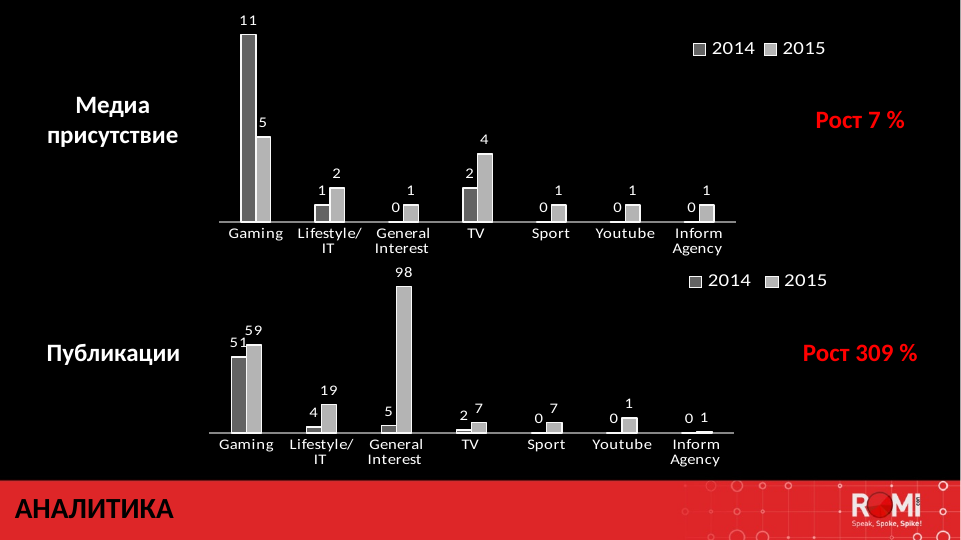
What type of chart is the top chart (Медиа присутствие)? Bar chart In the bottom chart (Публикации), which is larger: the 2015 value for Gaming or the 2015 value for General Interest? General Interest In the bottom chart (Публикации), which category has the highest 2015 value? General Interest In the top chart (Медиа присутствие), how many categories are shown on the x axis? 7 In the bottom chart (Публикации), what is the 2015 value for General Interest? 98 In the top chart (Медиа присутствие), what is the difference between the 2014 and 2015 values for Gaming? 6 In the bottom chart (Публикации), what is the 2014 value for Gaming? 51 In the top chart (Медиа присутствие), what is the 2014 value for Gaming? 11 In the top chart (Медиа присутствие), which category has the highest 2014 value? Gaming In the top chart (Медиа присутствие), what is the 2015 value for TV? 4 How many series does the legend of the bottom chart (Публикации) list? 2 In the bottom chart (Публикации), what is the difference between the 2015 and 2014 values for Lifestyle/IT? 15